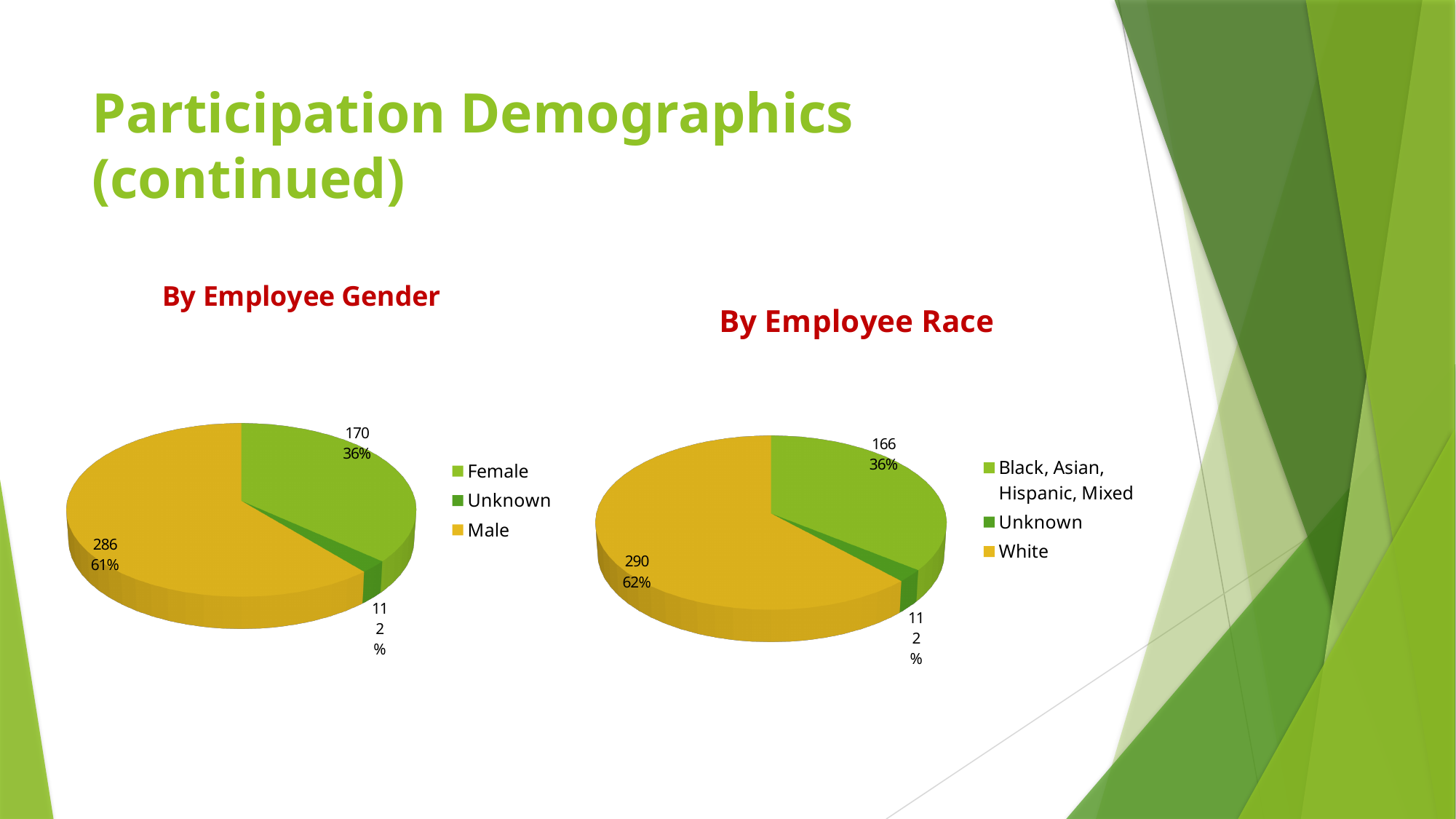
In the 'By Employee Race' chart, what is the value for White? 290 In the 'By Employee Race' chart, what colour is the White slice? Yellow In the 'By Employee Gender' chart, how many categories does the legend list? 3 In the 'By Employee Race' chart, which category has the largest slice? White In the 'By Employee Gender' chart, what is the value for Male? 286 In the 'By Employee Gender' chart, which category has the smallest slice? Unknown In the 'By Employee Gender' chart, what is the difference between the Male and Female values? 116 In the 'By Employee Race' chart, what is the value for Unknown? 11 In the 'By Employee Race' chart, which is larger: the value for White or the value for Black, Asian, Hispanic, Mixed? White In the 'By Employee Race' chart, what percentage share does White have? 62% In the 'By Employee Gender' chart, what percentage share does Female have? 36% What type of chart is the 'By Employee Gender' chart? Pie chart